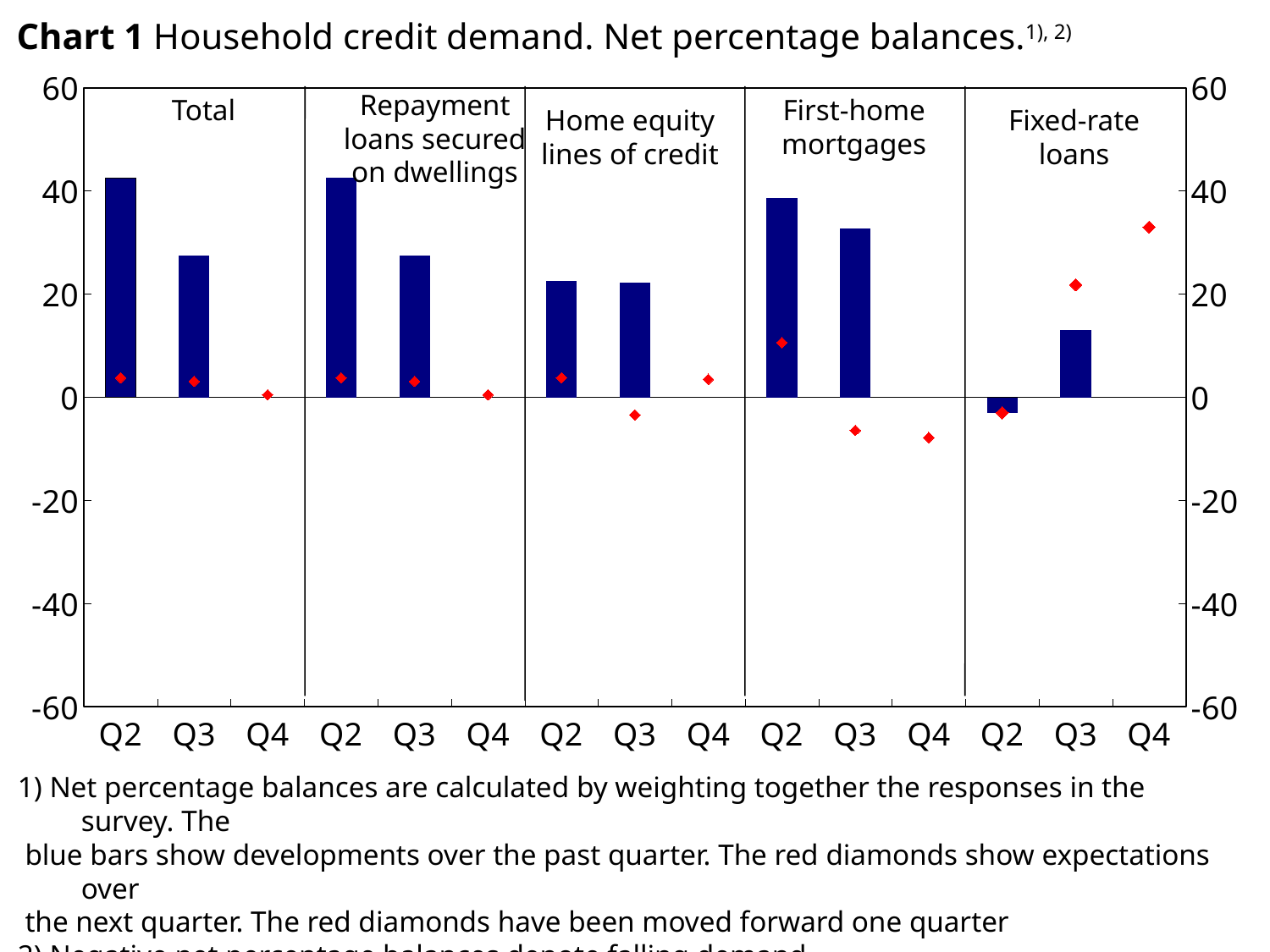
According to the footnote, what do the red diamonds show? Expectations over the next quarter Which panel has the lowest Q2 bar? Fixed-rate loans What kind of chart is Chart 1? bar chart In the Fixed-rate loans panel, do the red diamonds rise or fall from Q2 to Q4? rise In the Fixed-rate loans panel, is the Q3 bar greater or less than 20? less In the Total panel, is the Q2 bar greater or less than 40? greater In the First-home mortgages panel, which bar is larger, Q2 or Q3? Q2 In the Fixed-rate loans panel, is the Q4 red diamond greater or less than 20? greater How many loan categories (panels) does Chart 1 show? 5 In the Fixed-rate loans panel, which bar is larger, Q2 or Q3? Q3